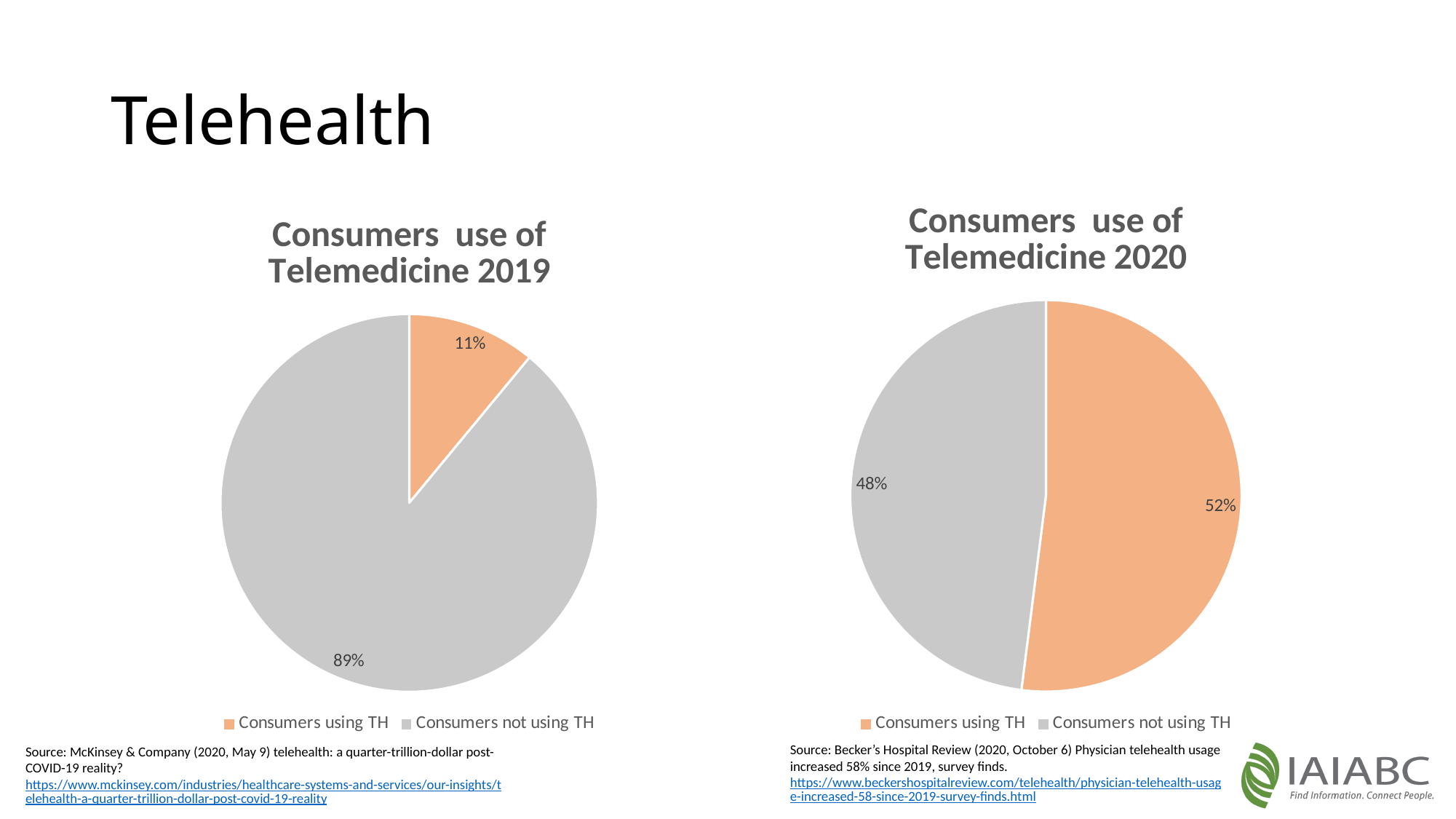
Which chart shows a larger share of consumers using TH, the 2019 chart or the 2020 chart? The 2020 chart In the 'Consumers use of Telemedicine 2019' chart, which slice is the largest? Consumers not using TH In the 'Consumers use of Telemedicine 2019' chart, what is the difference between the share not using TH and the share using TH? 78% In the 'Consumers use of Telemedicine 2020' chart, what share of consumers were using TH? 52% In the 'Consumers use of Telemedicine 2019' chart, what share of consumers were using TH? 11% In the 'Consumers use of Telemedicine 2020' chart, which slice is the smallest? Consumers not using TH In the 'Consumers use of Telemedicine 2020' chart, what is the difference between the share using TH and the share not using TH? 4% How many slices does the 'Consumers use of Telemedicine 2020' chart have? 2 What type of chart is the 'Consumers use of Telemedicine 2019' chart? Pie chart In the 'Consumers use of Telemedicine 2019' chart, what share of consumers were not using TH? 89% In the 'Consumers use of Telemedicine 2020' chart, what colour represents consumers using TH? Orange In the 'Consumers use of Telemedicine 2020' chart, what share of consumers were not using TH? 48%